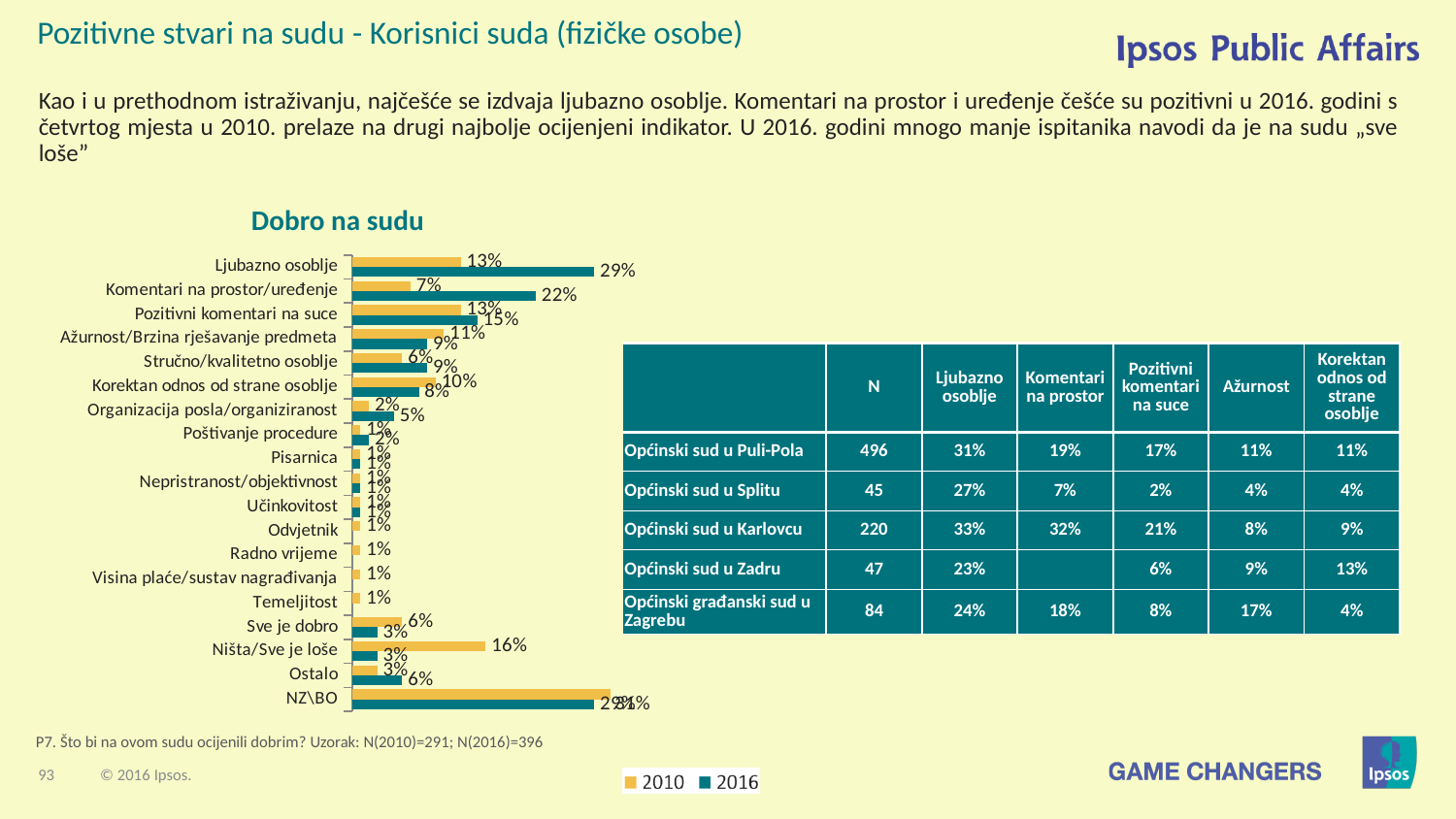
In the "Dobro na sudu" chart, what is the difference between the 2016 and 2010 values for Komentari na prostor/uređenje? 15% In the "Dobro na sudu" chart, what is the 2010 value for Ništa/Sve je loše? 16% In the "Dobro na sudu" chart, what is the 2016 value for Pozitivni komentari na suce? 15% How many categories are shown on the "Dobro na sudu" chart? 19 In the "Dobro na sudu" chart, what is the difference between the 2016 and 2010 values for Ljubazno osoblje? 16% What kind of chart is "Dobro na sudu"? bar chart In the "Dobro na sudu" chart, what is the 2010 value for Komentari na prostor/uređenje? 7% In the "Dobro na sudu" chart, what is the 2016 value for Ljubazno osoblje? 29% In the "Dobro na sudu" chart, which is larger for Sve je dobro: the 2010 value or the 2016 value? 2010 In the "Dobro na sudu" chart, which is larger for Ništa/Sve je loše: the 2010 value or the 2016 value? 2010 How many series does the legend of the "Dobro na sudu" chart list? 2